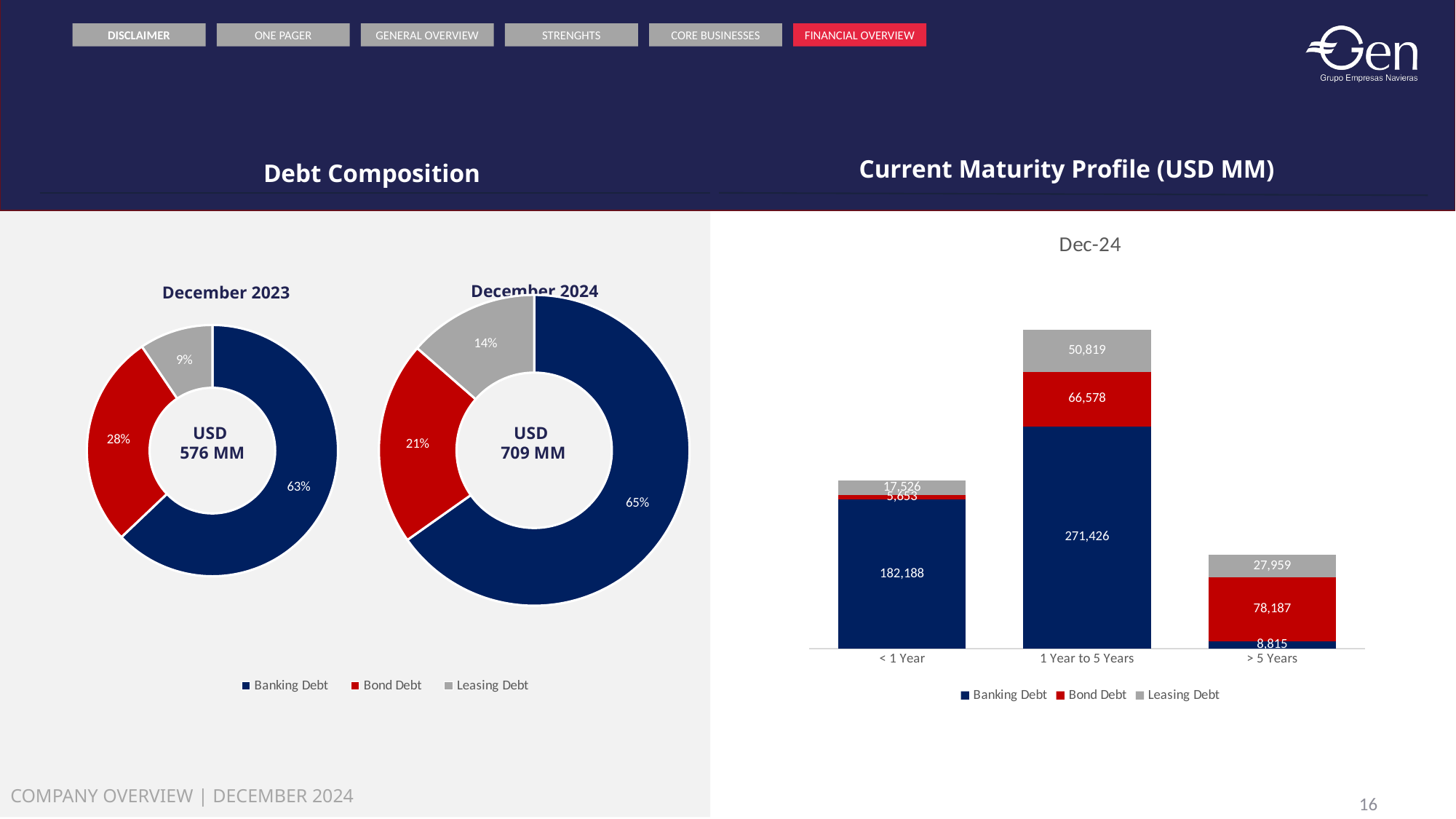
In the Current Maturity Profile chart, which maturity bucket has the lowest Banking Debt? > 5 Years In the Current Maturity Profile chart, what is the Banking Debt value for 1 Year to 5 Years? 271,426 In the Current Maturity Profile chart, what is the total of the 1 Year to 5 Years stacked bar? 388,823 In the December 2023 donut chart, which category has the smallest share? Leasing Debt In the Current Maturity Profile chart, what is the Bond Debt value for > 5 Years? 78,187 Is the Bond Debt share larger in the December 2023 donut chart or the December 2024 donut chart? December 2023 In the December 2023 donut chart, what share of debt is Banking Debt? 63% What kind of chart is the Current Maturity Profile chart? Stacked bar chart In the Current Maturity Profile chart, what is the difference between Leasing Debt for 1 Year to 5 Years and Leasing Debt for > 5 Years? 22,860 How many series does the legend of the Current Maturity Profile chart list? 3 In the December 2024 donut chart, what share of debt is Leasing Debt? 14% What total debt amount is shown in the centre of the December 2024 donut chart? USD 709 MM